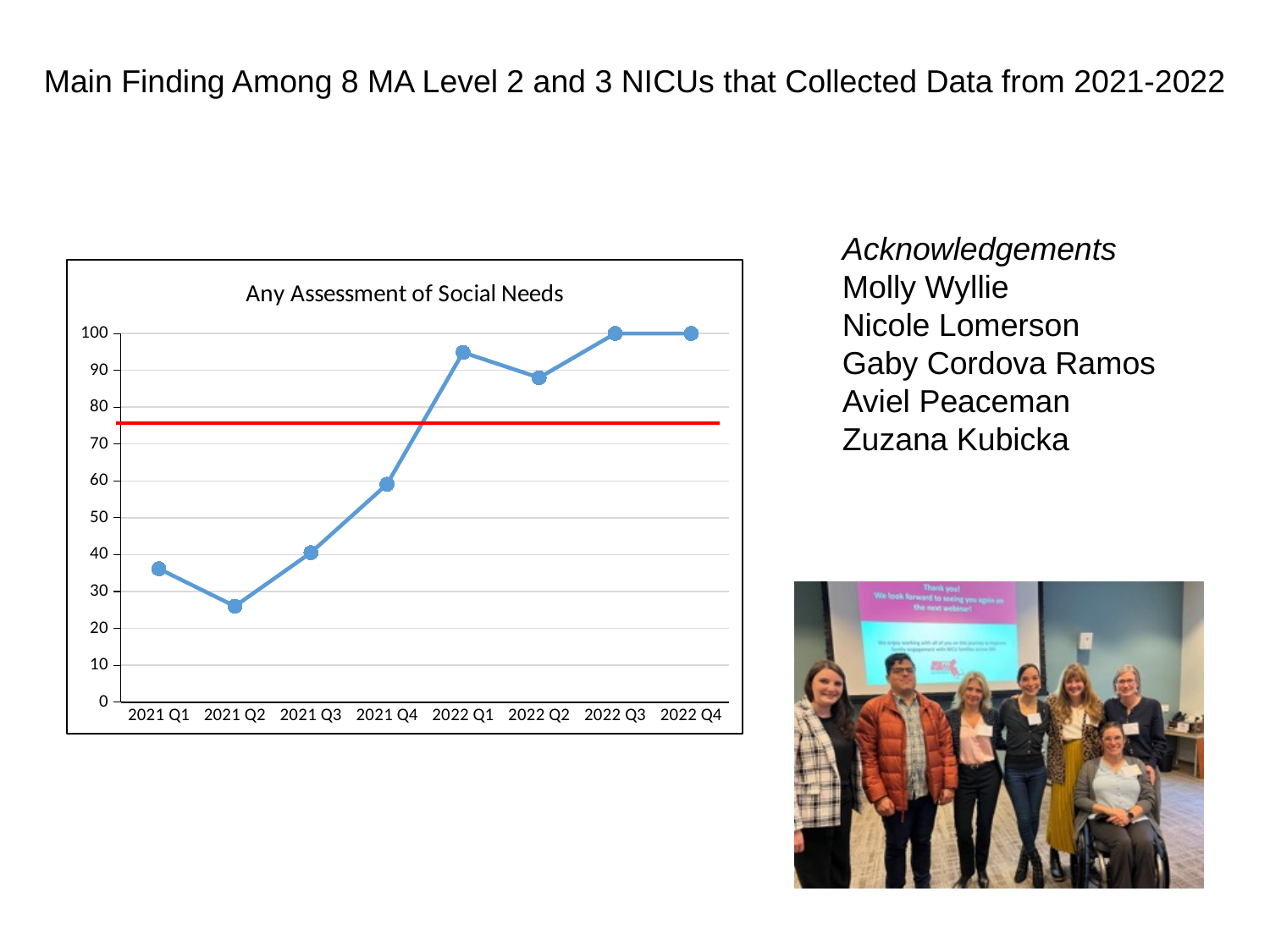
What is the title of the chart? Any Assessment of Social Needs Overall, do the values rise or fall from 2021 Q1 to 2022 Q4? rise Is the value for 2022 Q1 greater or less than 90? greater Is the value for 2022 Q2 greater or less than 90? less What kind of chart is shown on the slide? line chart Which is larger, the value for 2021 Q4 or the value for 2022 Q1? 2022 Q1 What is the value for 2022 Q3? 100 How many quarterly data points are plotted on the chart? 8 Which quarter has the lowest value on the chart? 2021 Q2 Is the value for 2021 Q1 greater or less than 40? less What is the value for 2022 Q4? 100